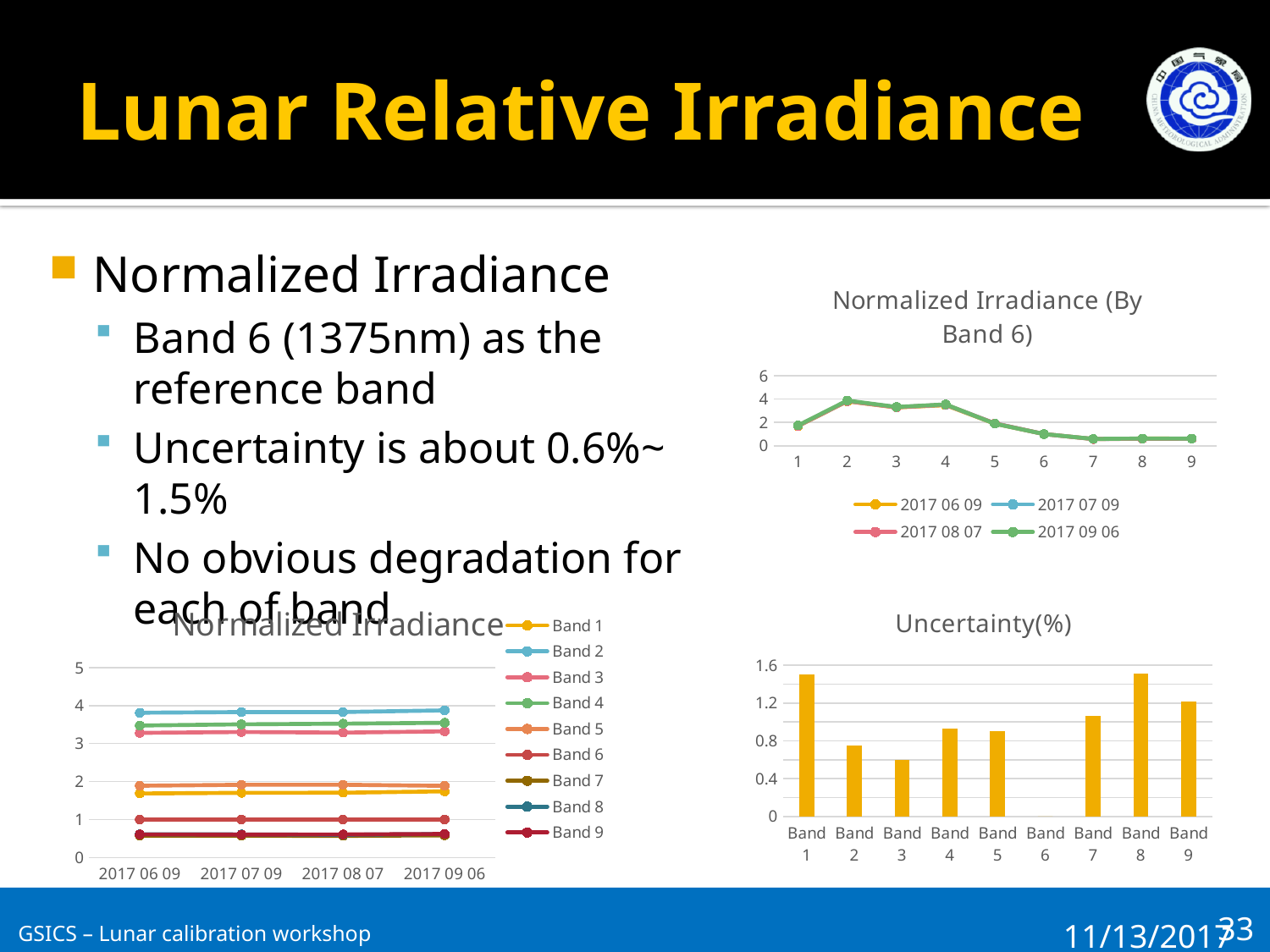
In the "Uncertainty(%)" chart, is the value for Band 1 greater or less than 1.2? greater How many series does the legend of the bottom-left "Normalized Irradiance" chart list? 9 In the bottom-left "Normalized Irradiance" chart, which band has the highest line? Band 2 What kind of chart is the "Normalized Irradiance (By Band 6)" chart? line chart How many series does the legend of the "Normalized Irradiance (By Band 6)" chart list? 4 In the "Uncertainty(%)" chart, which band has no visible bar? Band 6 What kind of chart is the "Uncertainty(%)" chart? bar chart How many dates are shown on the x axis of the bottom-left "Normalized Irradiance" chart? 4 In the "Uncertainty(%)" chart, is the value for Band 3 greater or less than 0.8? less How many bands are shown on the x axis of the "Uncertainty(%)" chart? 9 In the "Normalized Irradiance (By Band 6)" chart, which band has the highest value? 2 In the "Uncertainty(%)" chart, which is larger, the value for Band 9 or the value for Band 2? Band 9